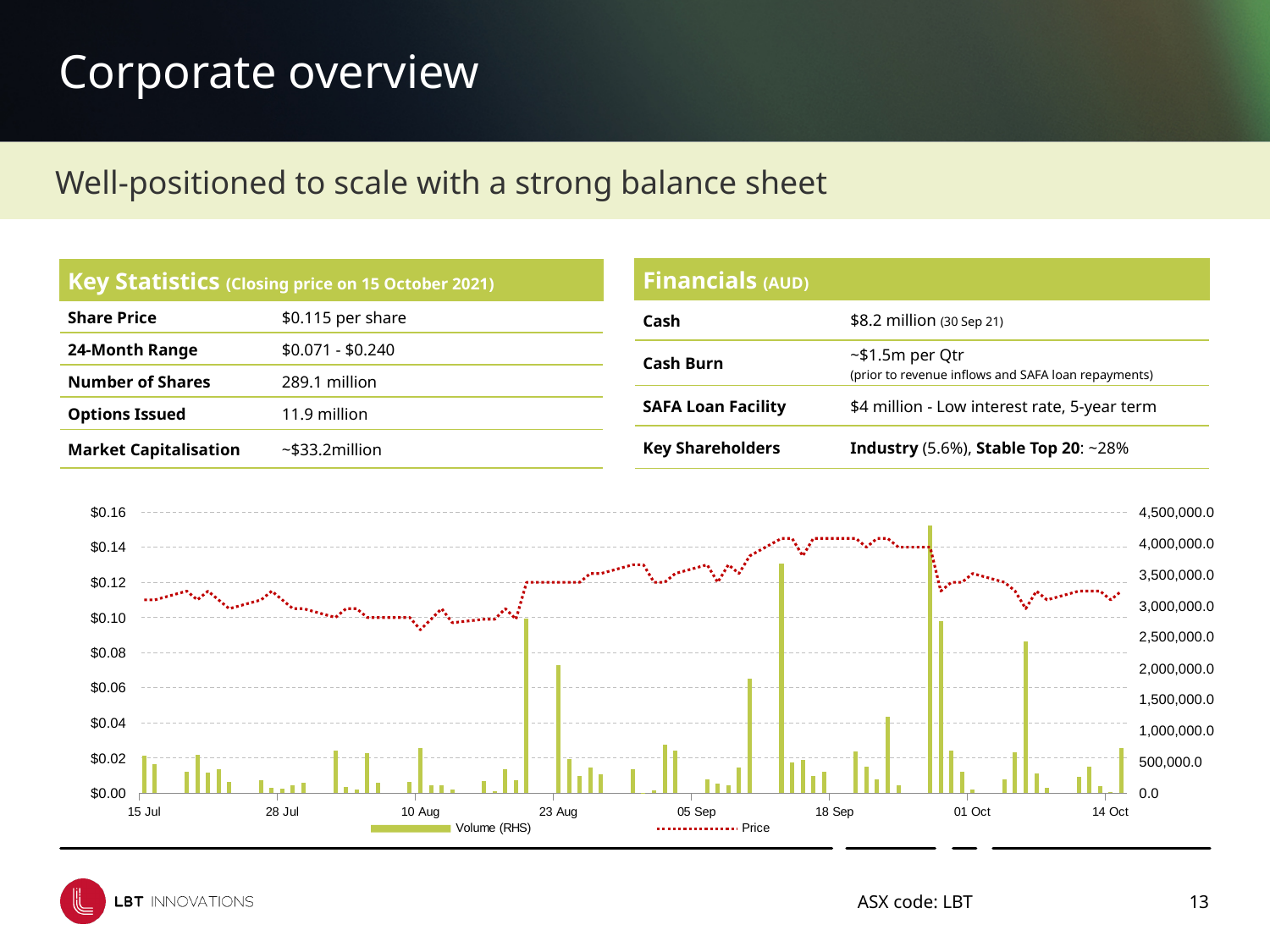
What kind of chart is shown on the slide? Combined bar and line chart How many series does the chart legend list? 2 How many date labels are shown along the x axis of the chart? 8 Does the price rise or fall between 18 Sep and 14 Oct? fall What is the highest value shown on the right (volume) axis of the chart? 4,500,000.0 What is the highest value shown on the left (price) axis of the chart? $0.16 Is the tallest volume bar greater or less than 3,500,000.0? greater Which series is plotted as bars in the chart? Volume (RHS) Is the price around 18 Sep greater or less than $0.12? greater Is the price at 15 Jul greater or less than $0.12? less What are the two series named in the chart legend? Volume (RHS) and Price Does the price rise or fall between 10 Aug and 18 Sep? rise